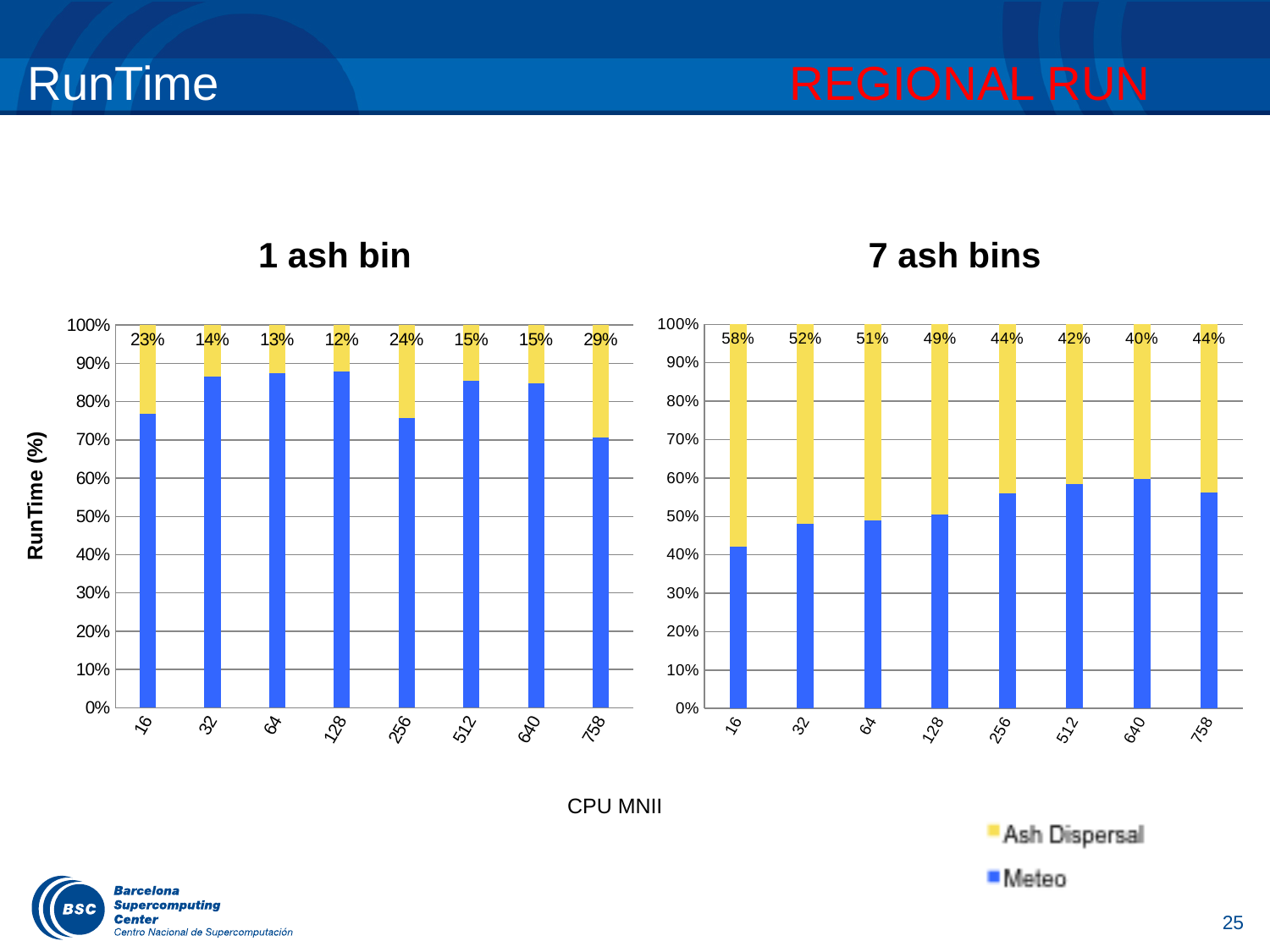
How many CPU counts are shown on the x axis of the '1 ash bin' chart? 8 In the '7 ash bins' chart, which CPU count has the lowest labelled Ash Dispersal percentage? 640 In the '7 ash bins' chart, is the Meteo share for 16 CPUs greater or less than 50%? less In the '7 ash bins' chart, what is the difference in percentage points between the Ash Dispersal labels for 16 CPUs and 640 CPUs? 18 What kind of chart is the '7 ash bins' chart? Stacked bar chart How many series does the legend list? 2 In the '1 ash bin' chart, which CPU count has the highest labelled Ash Dispersal percentage? 758 Is the Ash Dispersal label for 256 CPUs larger in the '1 ash bin' chart or the '7 ash bins' chart? 7 ash bins In the '1 ash bin' chart, what is the Ash Dispersal percentage labelled for 16 CPUs? 23% In the '7 ash bins' chart, what is the Ash Dispersal percentage labelled for 128 CPUs? 49% In the '1 ash bin' chart, which CPU count has the lowest labelled Ash Dispersal percentage? 128 In the '7 ash bins' chart, which CPU count has the highest labelled Ash Dispersal percentage? 16